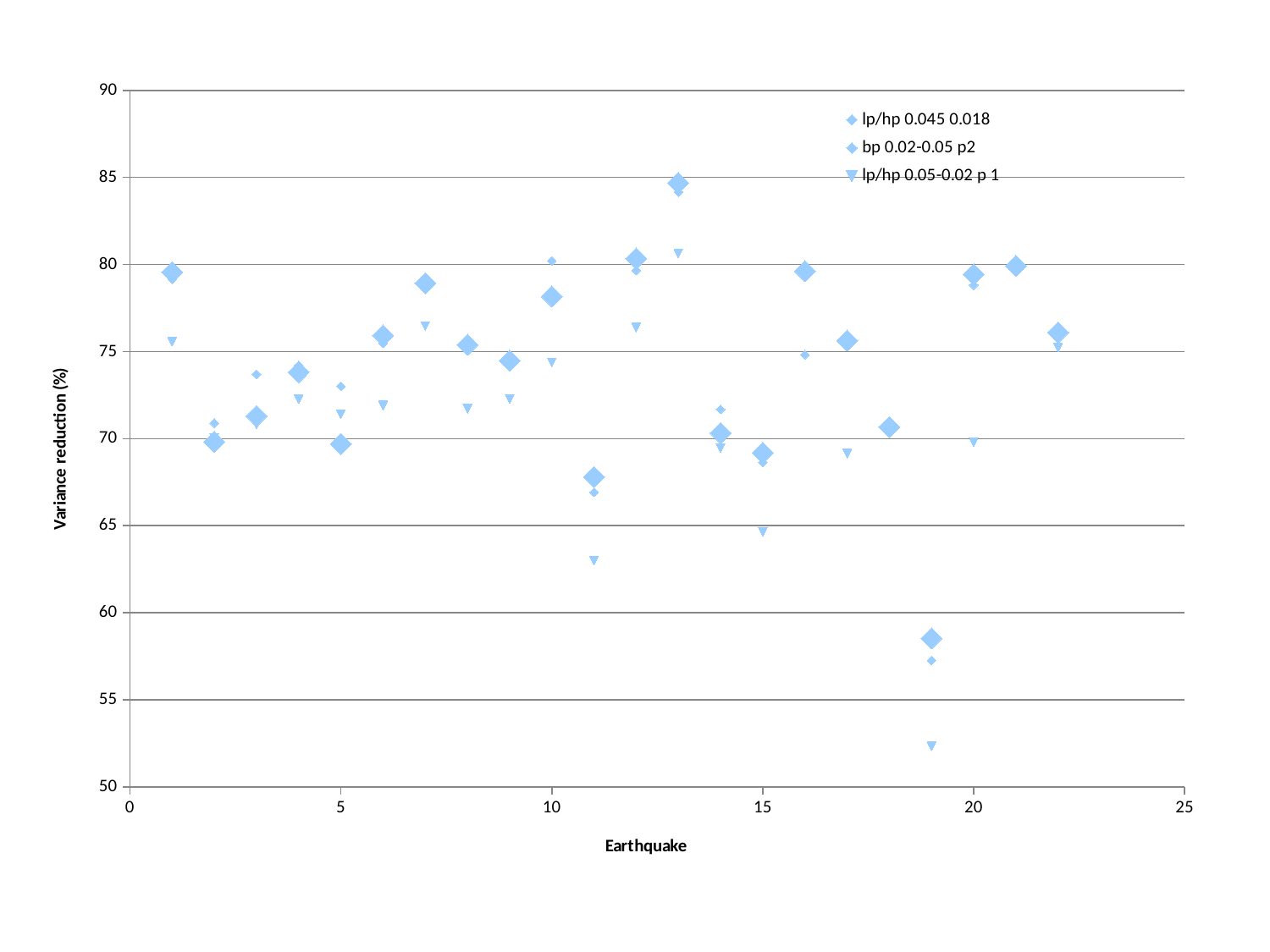
What is the title of the y axis? Variance reduction (%) Is the value for the lp/hp 0.05-0.02 p 1 series at earthquake 11 greater or less than 65? less Is the value for the lp/hp 0.045 0.018 series at earthquake 13 greater or less than 80? greater What is the title of the x axis? Earthquake How many series does the legend list? 3 Is the value for the lp/hp 0.045 0.018 series at earthquake 19 greater or less than 60? less How many earthquakes are plotted along the x axis? 22 Which earthquake has the highest variance reduction for the lp/hp 0.045 0.018 series? 13 At earthquake 13, which series has the larger value: lp/hp 0.045 0.018 or lp/hp 0.05-0.02 p 1? lp/hp 0.045 0.018 Which earthquake has the lowest variance reduction for the lp/hp 0.05-0.02 p 1 series? 19 What kind of chart is shown on the slide? scatter chart